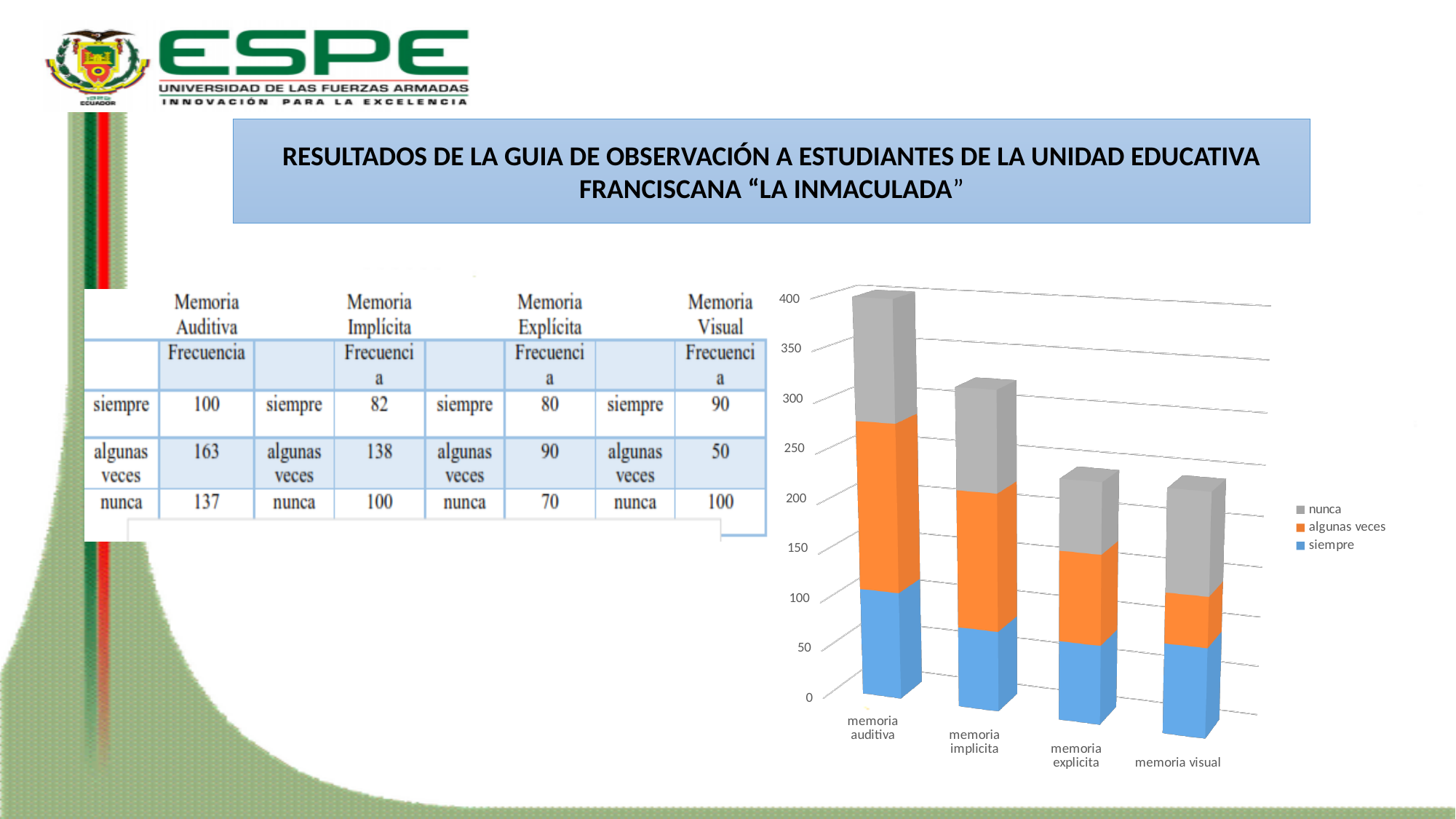
Which category has the tallest stacked bar in the chart? memoria auditiva Which is larger: the 'algunas veces' value for memoria auditiva or for memoria visual? memoria auditiva What kind of chart is shown on the right of the slide? stacked bar chart Is the total of the stacked bar for memoria auditiva greater or less than 350? greater What is the total of the stacked bar for memoria auditiva? 400 What is the total of the stacked bar for memoria implicita? 320 Which colour represents the 'siempre' series in the chart? blue Is the total of the stacked bar for memoria explicita greater or less than 300? less How many categories are plotted along the x axis of the chart? 4 How many series does the chart legend list? 3